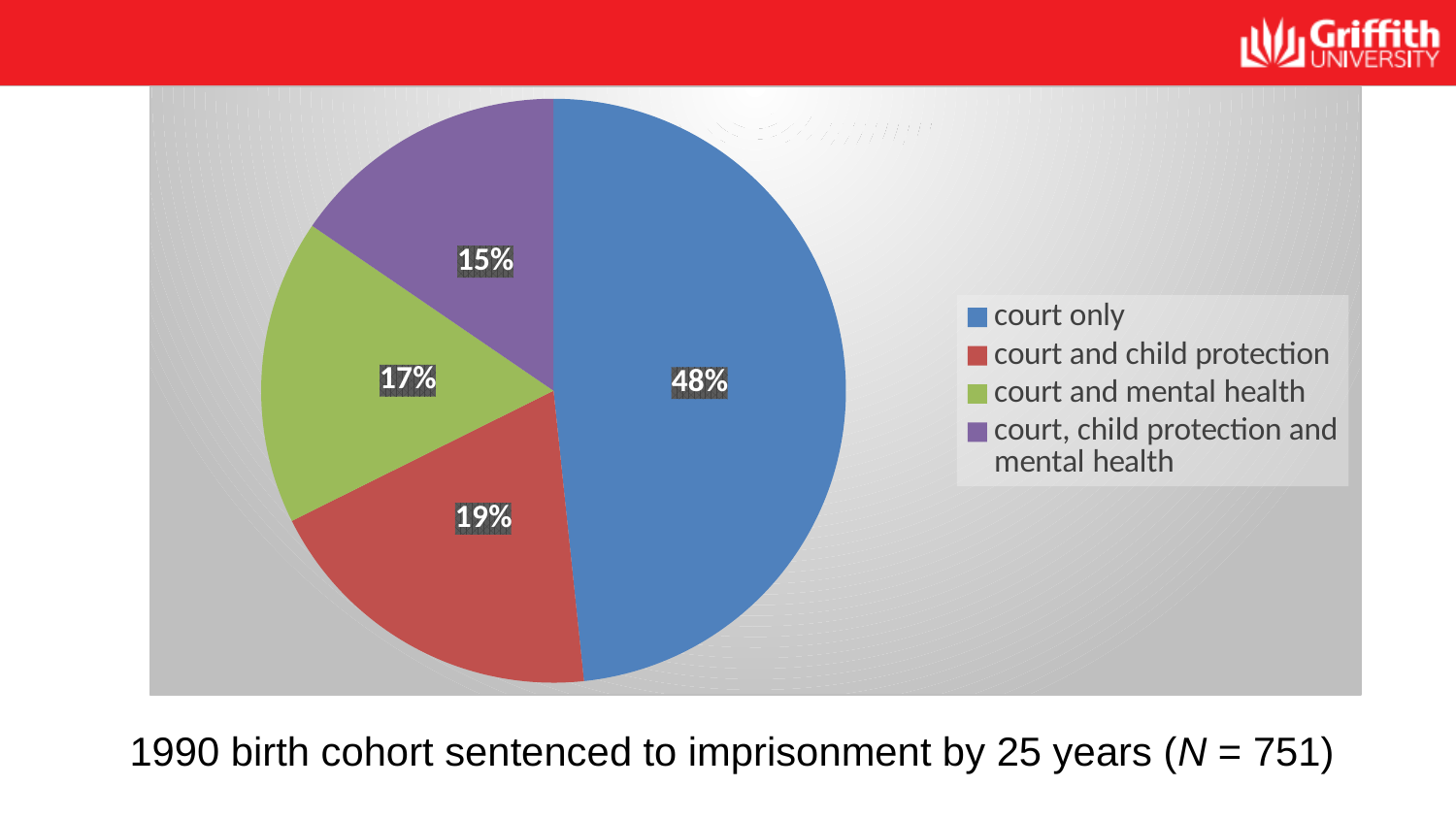
How many entries does the legend list? 4 What is the difference in percentage points between the "court only" slice and the "court and child protection" slice? 29 What percentage of the pie is labelled "court and child protection"? 19% What colour is the "court and child protection" slice? red What percentage of the pie is labelled "court only"? 48% How many slices does the pie chart have? 4 Which category has the largest slice of the pie? court only What kind of chart is shown on the slide? pie chart What percentage of the pie is labelled "court and mental health"? 17% What percentage of the pie is labelled "court, child protection and mental health"? 15% Which category has the smallest slice of the pie? court, child protection and mental health Which is larger: the "court and mental health" slice or the "court, child protection and mental health" slice? court and mental health